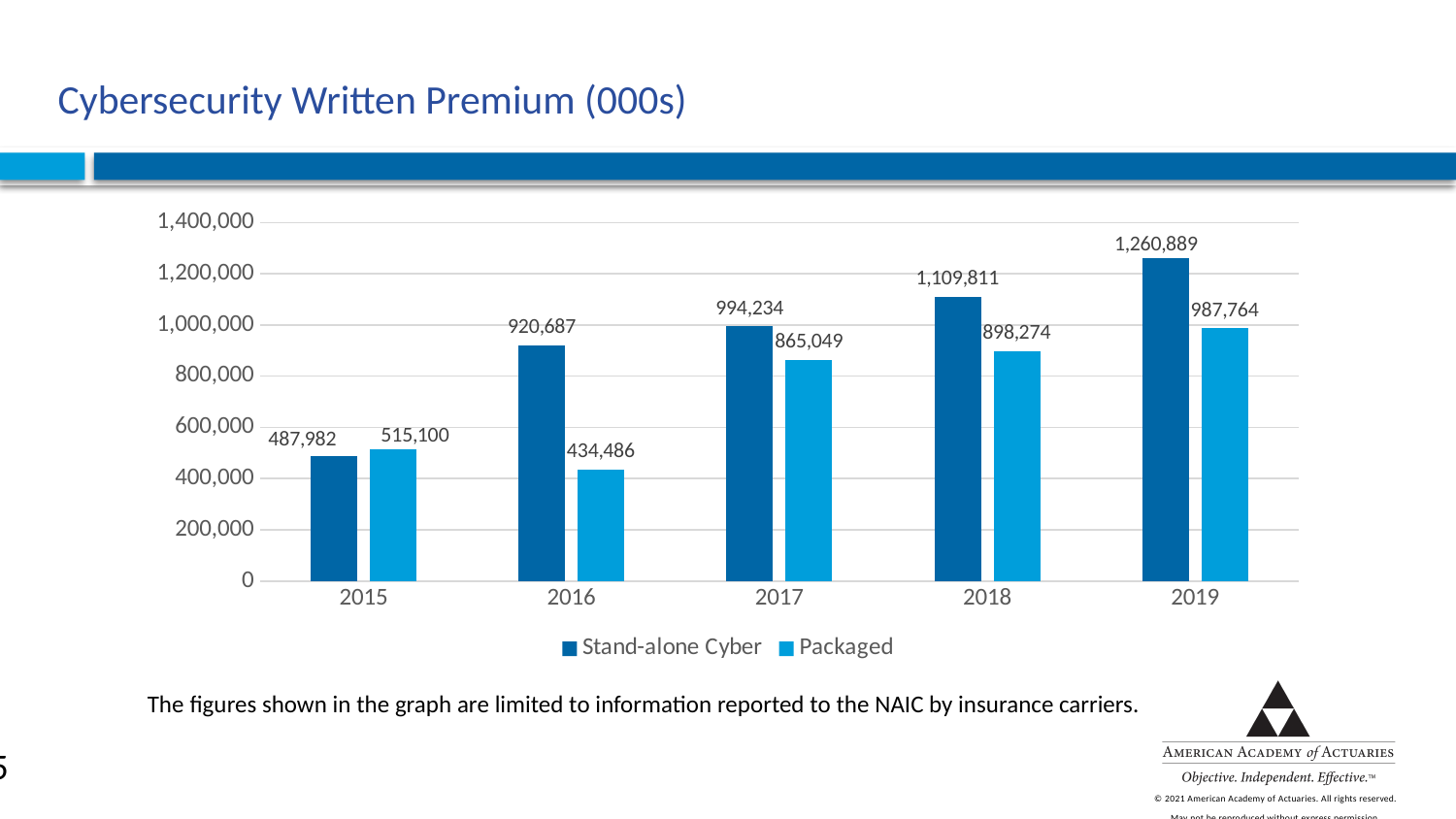
Is the Packaged written premium for 2018 greater or less than 1,000,000? less What is the Stand-alone Cyber written premium for 2017? 994,234 What is the Stand-alone Cyber written premium for 2019? 1,260,889 What kind of chart is shown on the slide? bar chart How many series does the legend list? 2 What is the Packaged written premium for 2016? 434,486 What is the difference between the Stand-alone Cyber and Packaged written premium in 2016? 486,201 How many years are shown on the x axis? 5 Which year has the lowest Stand-alone Cyber written premium? 2015 What is the difference between the Stand-alone Cyber and Packaged written premium in 2019? 273,125 In 2015, which is larger: Stand-alone Cyber or Packaged written premium? Packaged Which year has the highest Packaged written premium? 2019